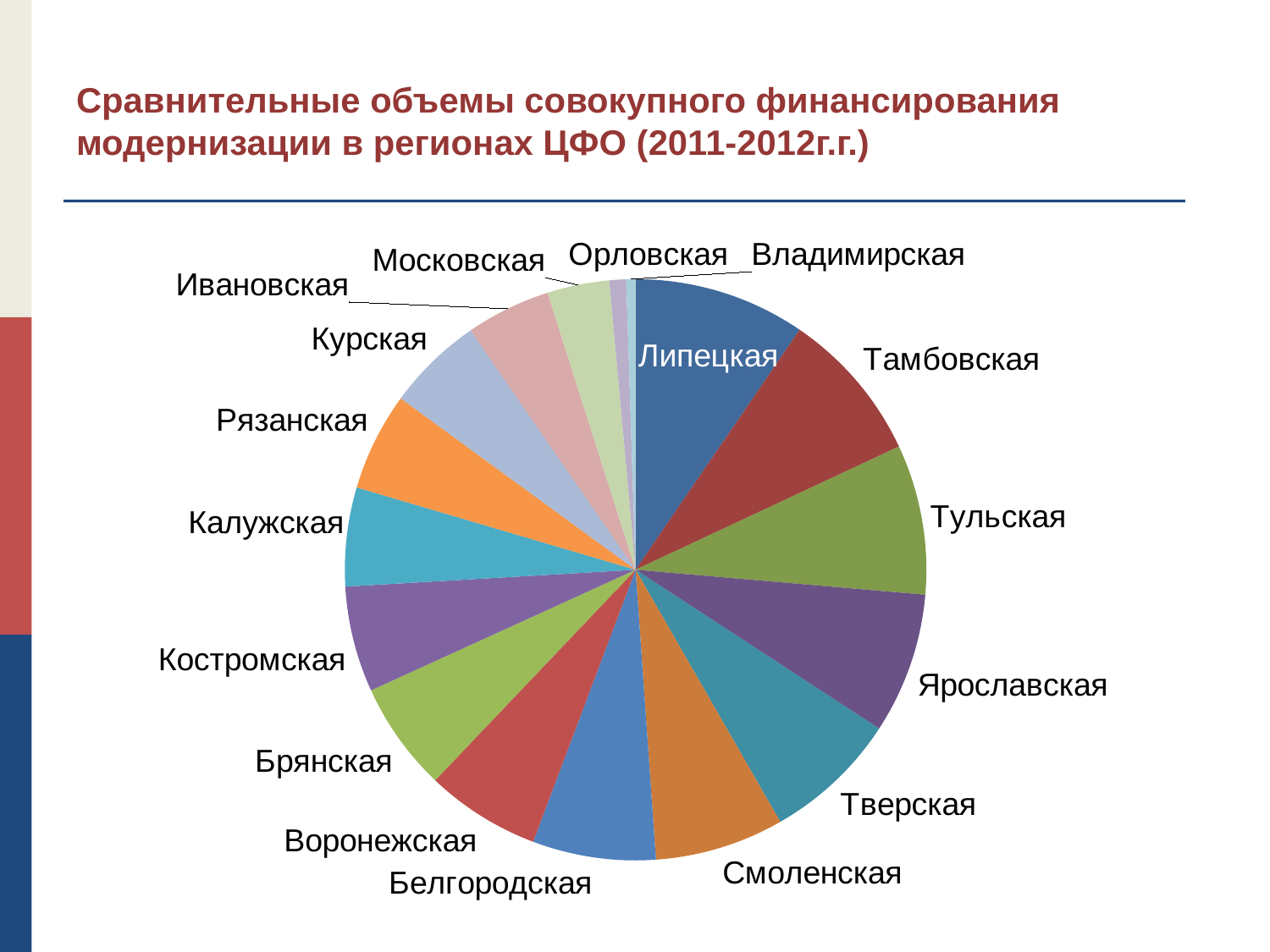
What kind of chart is shown on the slide? pie chart Which region has the smallest slice of the pie? Владимирская Which region's label is printed inside its slice rather than outside the pie? Липецкая Which region has the largest slice of the pie? Липецкая Which slice is larger, Рязанская or Московская? Рязанская Which slice is larger, Ярославская or Костромская? Ярославская Which slice is larger, Липецкая or Курская? Липецкая How many regions (slices) are shown in the pie chart? 17 What is the title of the slide containing the pie chart? Сравнительные объемы совокупного финансирования модернизации в регионах ЦФО (2011-2012г.г.)